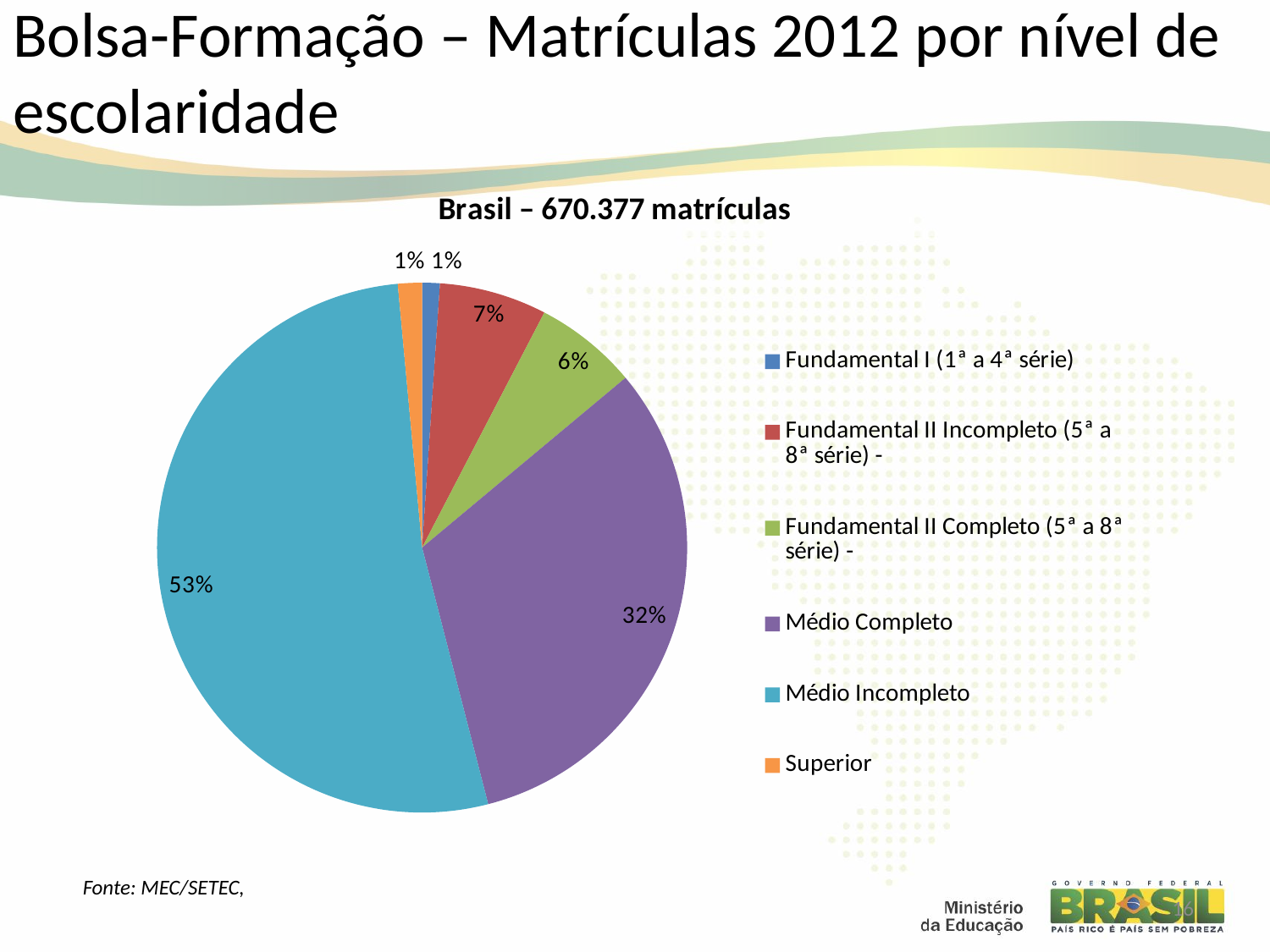
What percentage is shown for Médio Completo? 32% How many categories does the pie chart show? 6 What percentage is shown for Fundamental II Incompleto (5ª a 8ª série)? 7% What type of chart is shown on the slide? Pie chart What is the title shown above the chart? Brasil – 670.377 matrículas What share of the pie does Médio Incompleto represent? 53% Which education level has the largest share of matrículas? Médio Incompleto Which colour represents Superior in the legend? Orange Which is larger, the share for Fundamental II Incompleto or Fundamental II Completo? Fundamental II Incompleto What is the combined share of Médio Completo and Médio Incompleto? 85% What percentage is shown for Fundamental II Completo (5ª a 8ª série)? 6% What is the difference in percentage points between Médio Incompleto and Médio Completo? 21